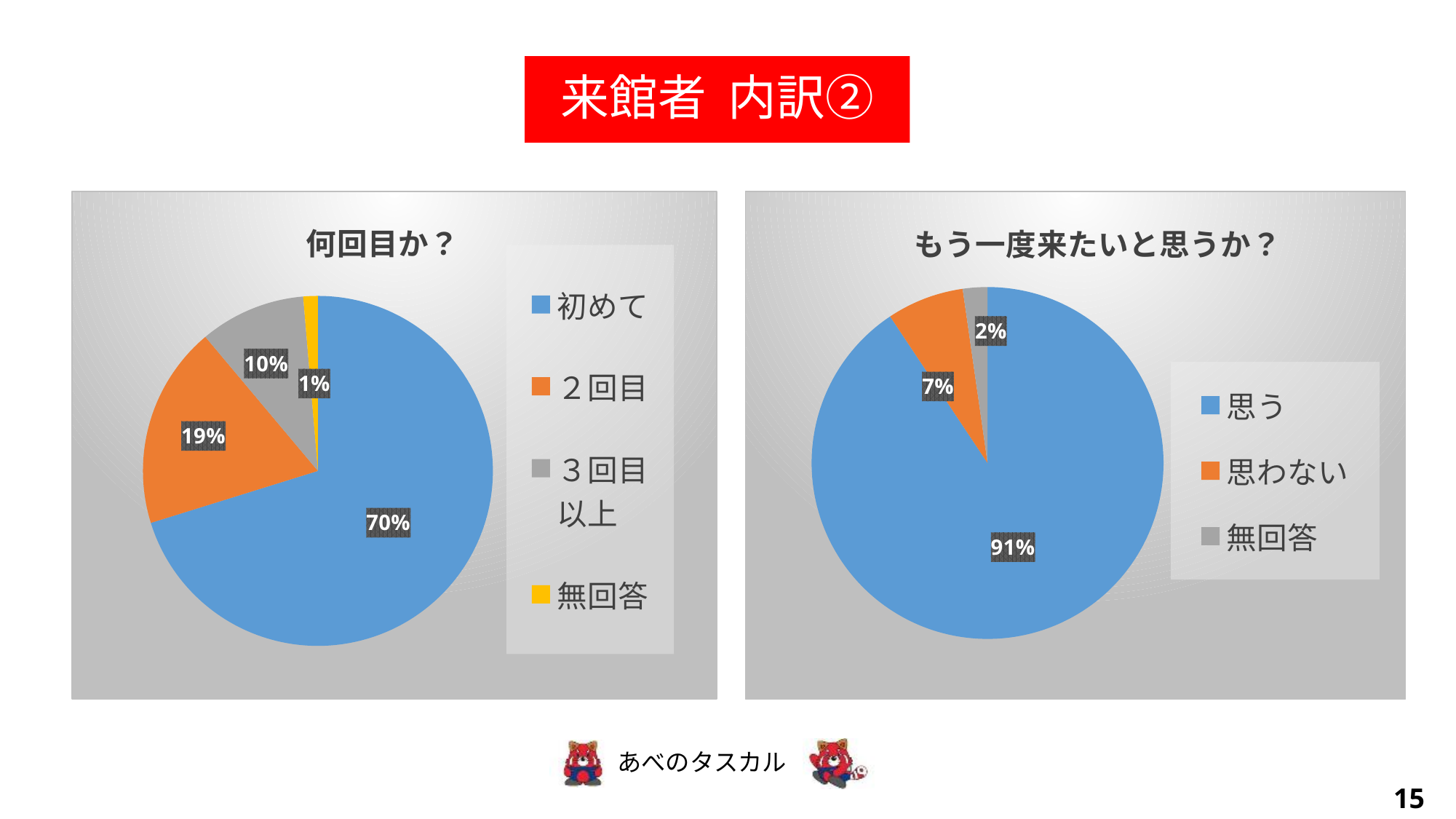
In the chart titled もう一度来たいと思うか？, which category is the largest? 思う In the chart titled 何回目か？, what is the value for ２回目? 19% In the chart titled もう一度来たいと思うか？, which is larger, 思わない or 無回答? 思わない In the chart titled 何回目か？, which category has the smallest slice? 無回答 In the chart titled 何回目か？, what is the difference between 初めて and ２回目? 51% In the chart titled もう一度来たいと思うか？, what share of the pie is 思う? 91% In the chart titled もう一度来たいと思うか？, what is the value for 思わない? 7% In the chart titled もう一度来たいと思うか？, what colour is the 無回答 slice? Gray In the chart titled 何回目か？, what share of the pie is 初めて? 70% In the chart titled 何回目か？, what is the value for ３回目以上? 10% In the chart titled 何回目か？, how many categories does the legend list? 4 What kind of chart is the chart titled もう一度来たいと思うか？? Pie chart